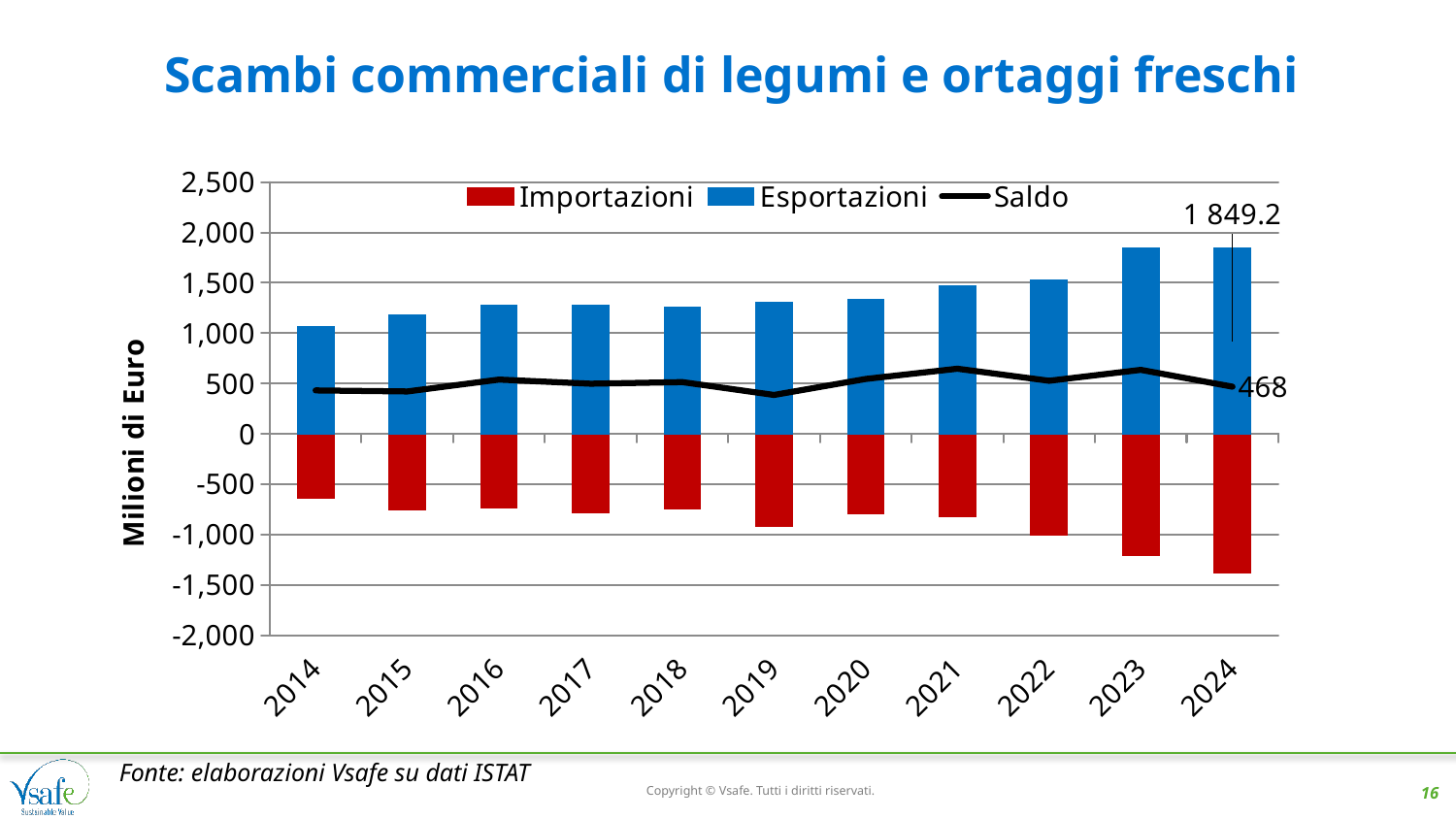
How many years are shown on the x axis? 11 Is the value for Esportazioni in 2014 greater or less than 1,500? less Do the Esportazioni values generally rise or fall from 2014 to 2024? rise Is the value for Importazioni in 2024 greater or less than -1,000? less In which year is Esportazioni lowest? 2014 In which year is the Importazioni bar the most negative (largest in magnitude)? 2024 Is the value for Saldo in 2019 greater or less than 500? less How many series does the legend list? 3 What is the value of Esportazioni in 2024? 1 849.2 What is the label of the y axis? Milioni di Euro What is the value of Saldo in 2024? 468 What kind of chart is shown on the slide? bar chart with a line